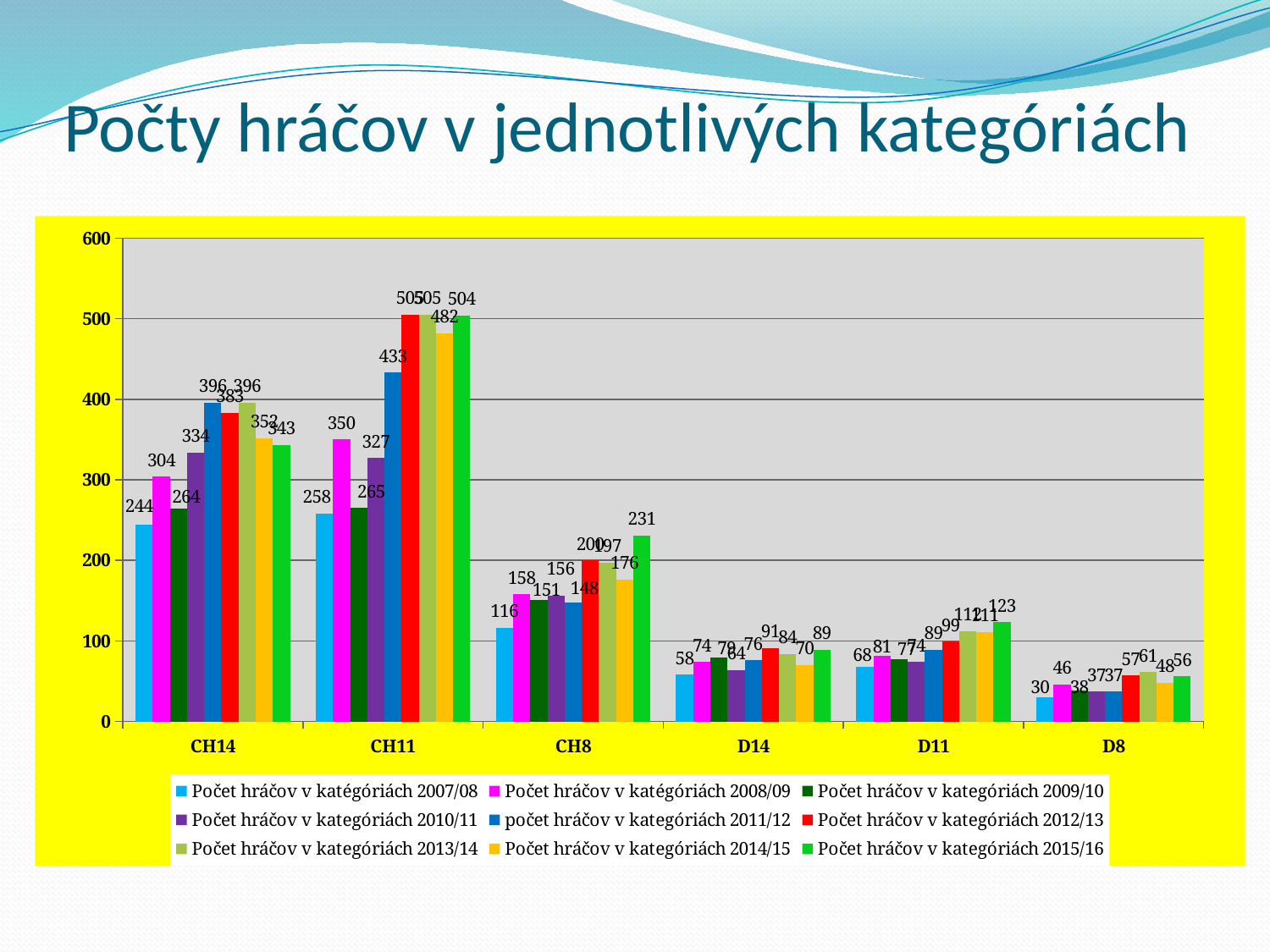
Is the value for CH11 in the series Počet hráčov v kategóriách 2014/15 greater or less than 400? greater How many categories are shown on the x axis? 6 What is the value for CH11 in the series Počet hráčov v kategóriách 2015/16? 504 What is the value for CH14 in the series Počet hráčov v katégóriách 2007/08? 244 What kind of chart is shown on the slide? bar chart What is the value for CH8 in the series Počet hráčov v kategóriách 2015/16? 231 In the series počet hráčov v kategóriách 2011/12, which is larger: CH11 or CH14? CH11 For CH14, what is the difference between the 2008/09 value and the 2007/08 value? 60 What is the value for D8 in the series Počet hráčov v katégóriách 2007/08? 30 Which category has the highest value in the series Počet hráčov v katégóriách 2008/09? CH11 How many series does the legend list? 9 Which category has the lowest value in the series Počet hráčov v katégóriách 2007/08? D8